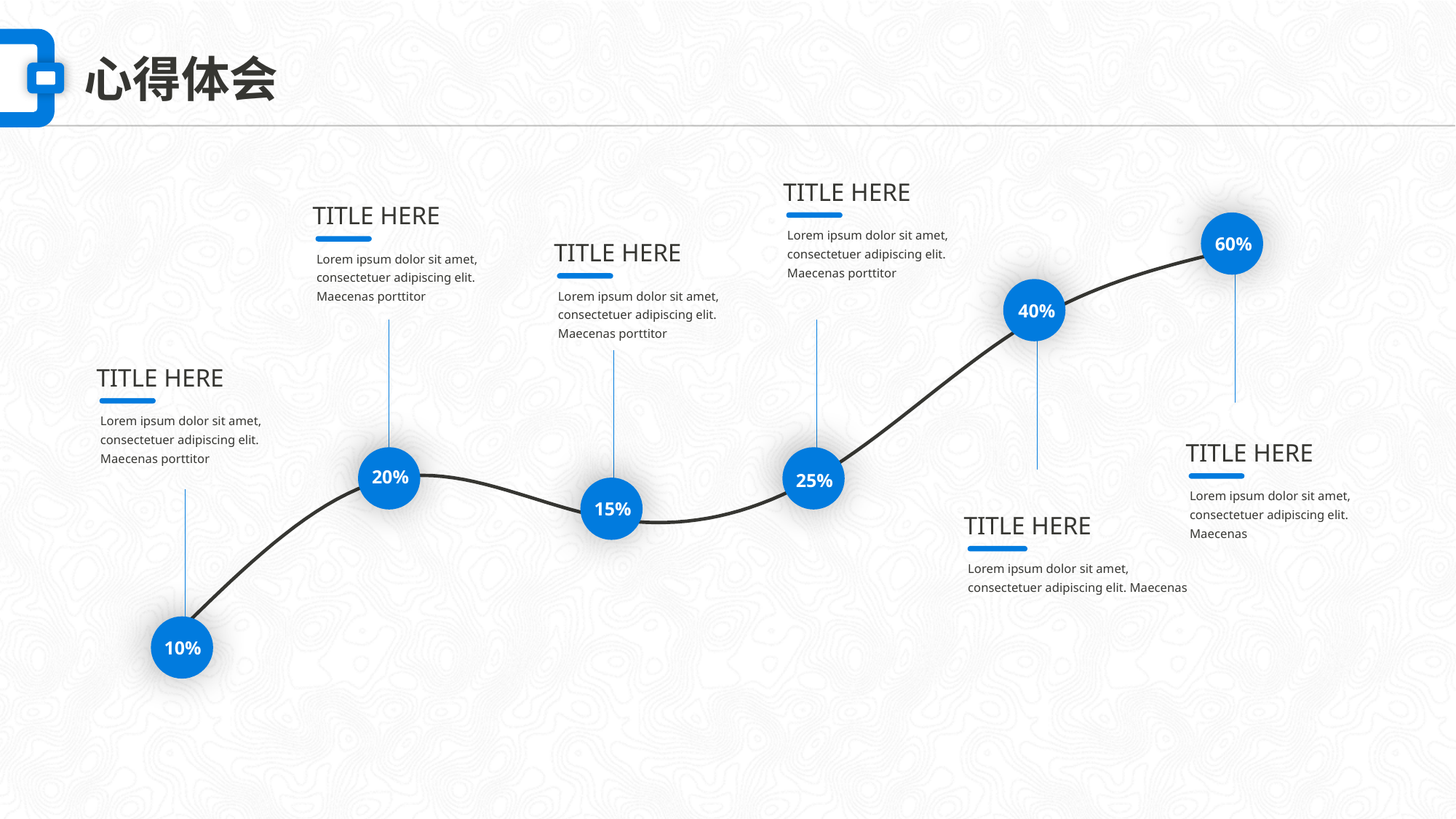
Do the values generally rise or fall from left to right along the line? rise Which point on the line has the lowest value? the leftmost point, 10% What is the value of the last (rightmost) point on the line? 60% What kind of chart is shown on the slide? line chart What is the value of the third point from the left on the line? 15% Which is larger, the second point or the third point on the line? the second point (20%) What is the difference between the last point (60%) and the fifth point (40%)? 20% How many data points are plotted on the line? 6 What colour are the circular data markers on the line? blue What is the value of the fifth point from the left on the line? 40% What is the value of the first (leftmost) point on the line? 10% Which point on the line has the highest value? the rightmost point, 60%